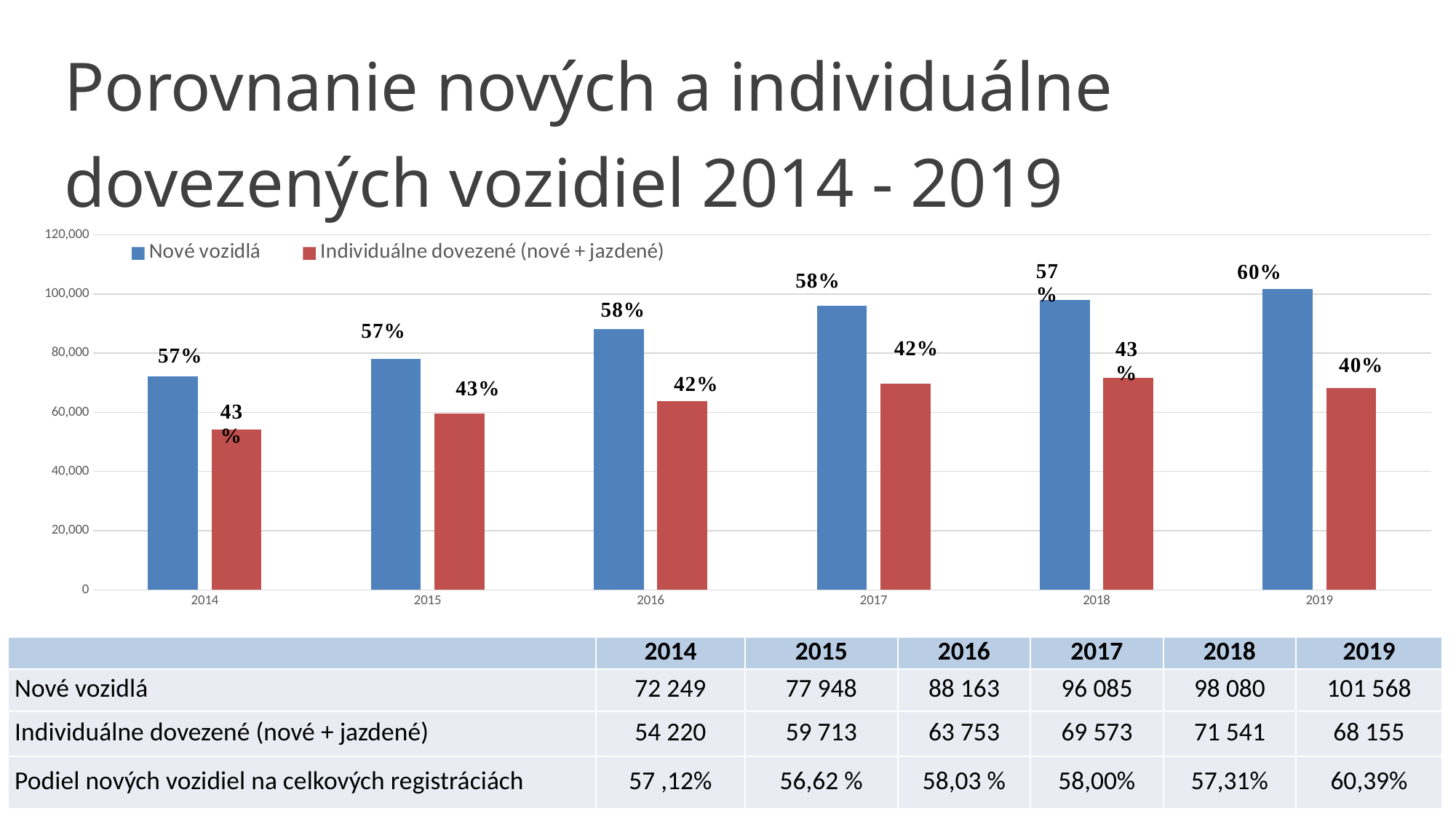
How many years are shown on the x axis of the chart? 6 According to the table under the chart, what is the value for Nové vozidlá in 2017? 96 085 In 2018, which series has the larger bar: Nové vozidlá or Individuálne dovezené (nové + jazdené)? Nové vozidlá Which colour represents Nové vozidlá in the chart legend? blue Is the value for Nové vozidlá in 2019 greater or less than 100,000? greater What percentage label is shown above the Nové vozidlá bar for 2019? 60% How many series does the chart legend list? 2 In which year is the Individuálne dovezené (nové + jazdené) bar the lowest? 2014 In which year is the Nové vozidlá bar the highest? 2019 What kind of chart is shown on the slide? bar chart Do the Nové vozidlá bars rise or fall from 2014 to 2019? rise What percentage label is shown above the Individuálne dovezené (nové + jazdené) bar for 2017? 42%